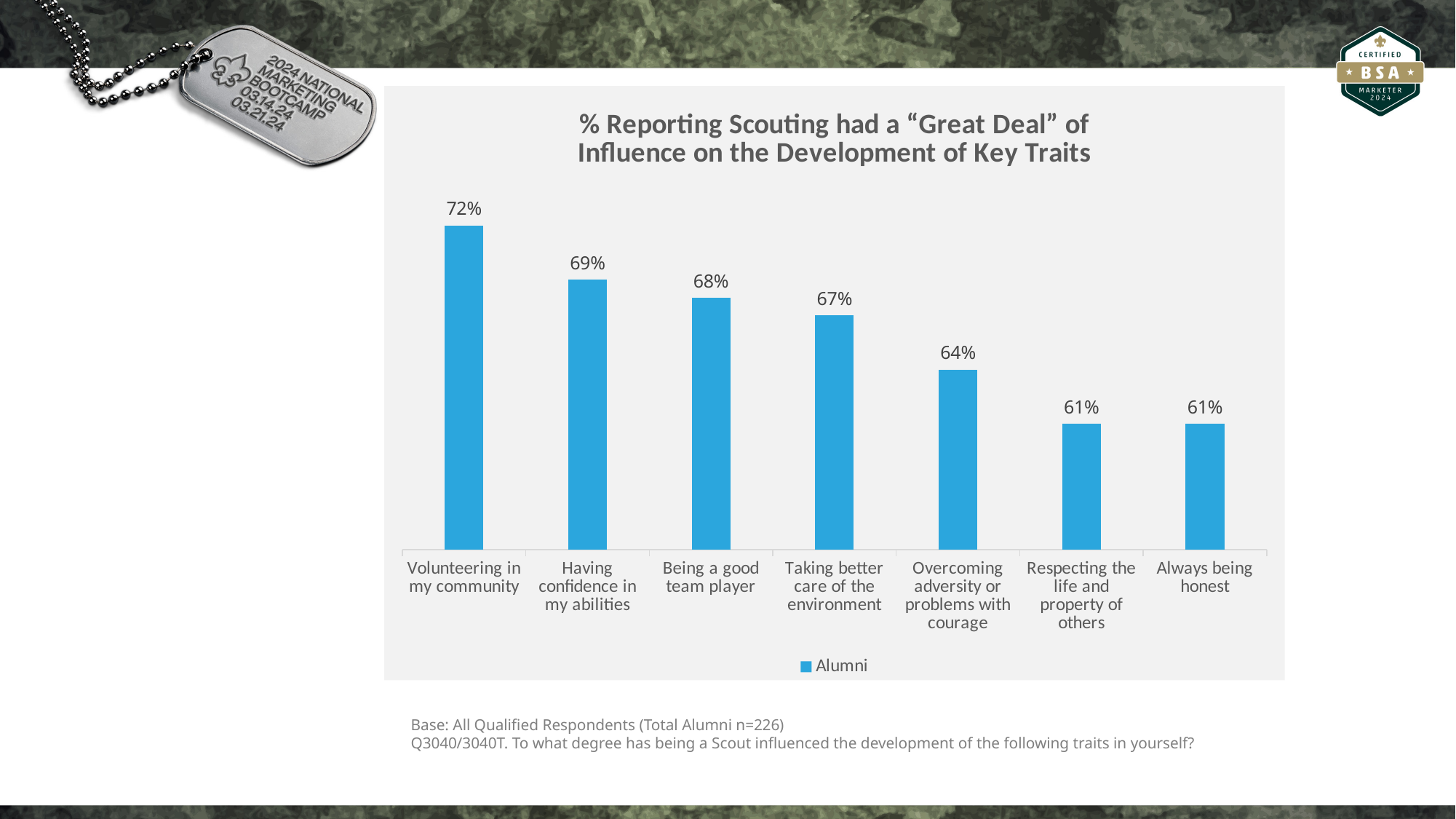
Which trait has the highest percentage on the chart? Volunteering in my community What percentage of alumni reported Scouting had a "Great Deal" of influence on volunteering in their community? 72% What is the value for "Overcoming adversity or problems with courage"? 64% How many traits (categories) are shown on the chart? 7 What series name is shown in the chart legend? Alumni What is the difference between the values for "Volunteering in my community" and "Always being honest"? 11 percentage points How many series does the legend list? 1 What is the value for "Taking better care of the environment"? 67% What is the lowest value shown on the chart? 61% What kind of chart is shown on the slide? Bar chart Do the values rise or fall moving from left to right along the x axis? Fall Which is larger: the value for "Having confidence in my abilities" or the value for "Being a good team player"? Having confidence in my abilities